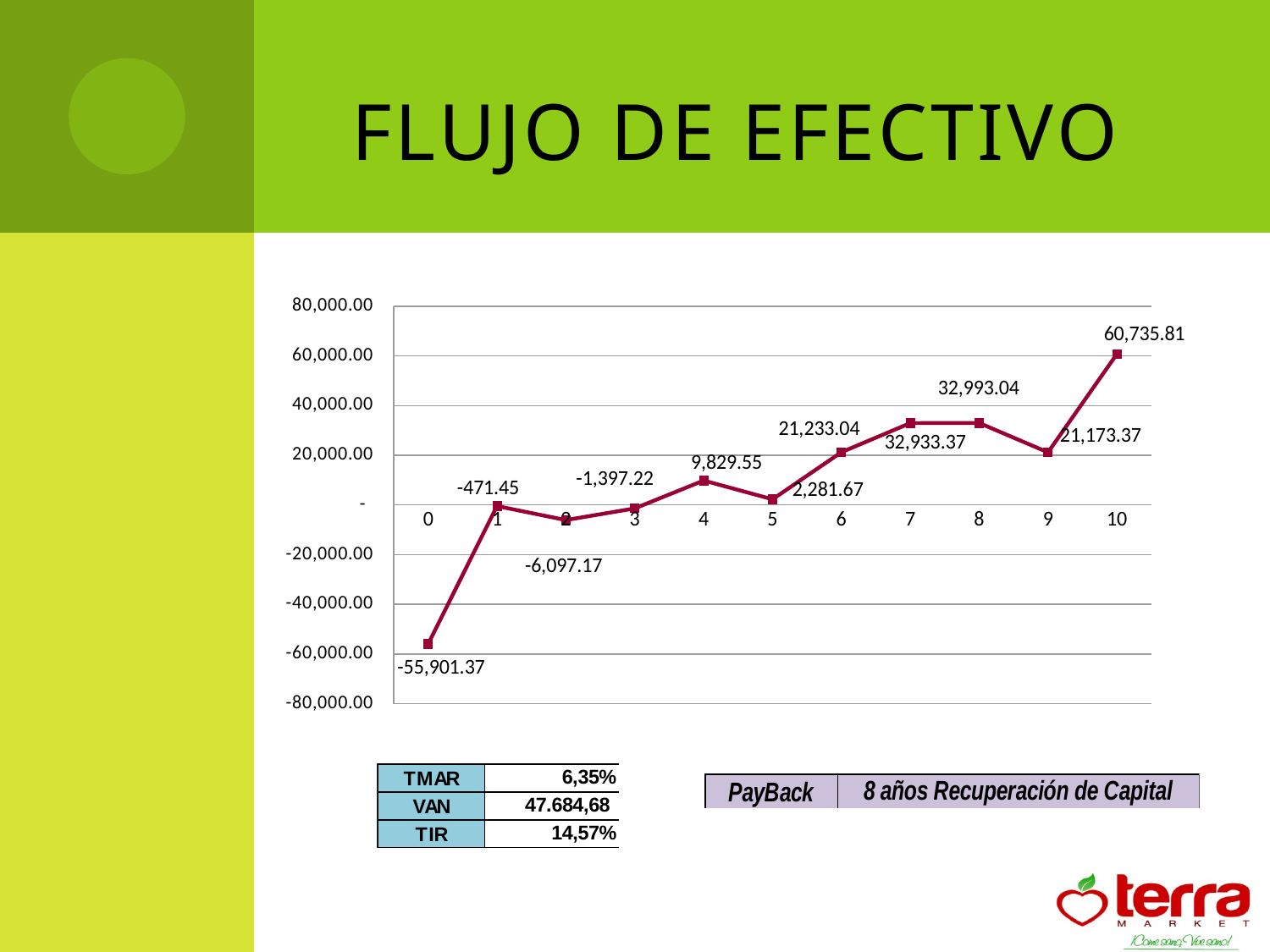
What is the difference between the values for period 4 and period 5? 7,547.88 Is the value for period 9 greater or less than 40,000.00? less What is the difference between the values for period 10 and period 9? 39,562.44 What is the value plotted for period 6? 21,233.04 What is the value plotted for period 10? 60,735.81 What is the value plotted for period 0? -55,901.37 What kind of chart is shown on the slide? line chart Overall, do the values rise or fall from period 0 to period 10? rise Which period has the highest value on the chart? 10 How many data points are plotted on the line chart? 11 Which period has the lowest value on the chart? 0 Which has the larger value, period 4 or period 5? period 4